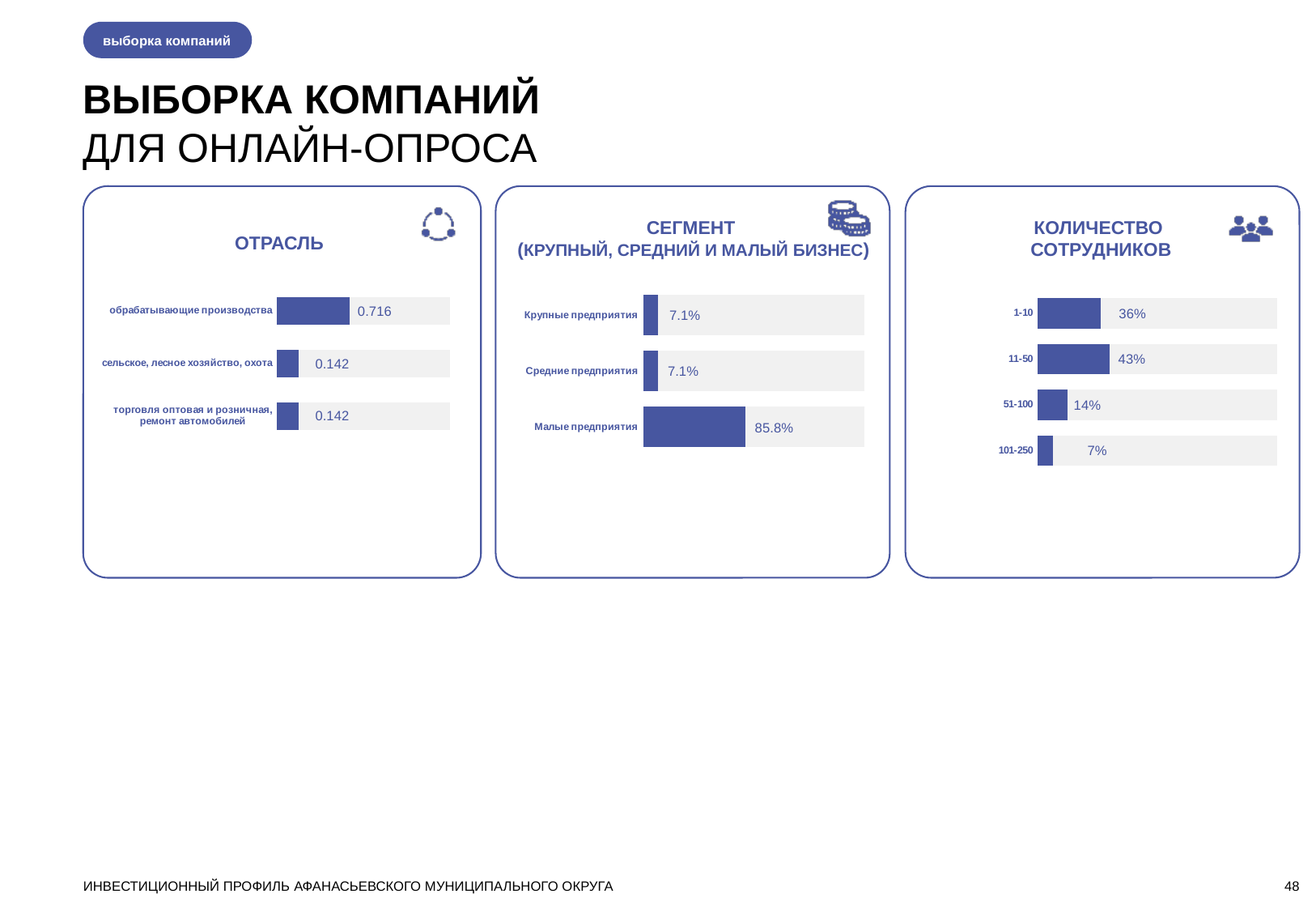
In the КОЛИЧЕСТВО СОТРУДНИКОВ chart, which is larger, 1-10 or 51-100? 1-10 In the ОТРАСЛЬ chart, how many categories are shown? 3 In the КОЛИЧЕСТВО СОТРУДНИКОВ chart, what is the value for 11-50? 43% In the ОТРАСЛЬ chart, what is the difference between обрабатывающие производства and сельское, лесное хозяйство, охота? 0.574 In the СЕГМЕНТ chart, what is the difference between Малые предприятия and Средние предприятия? 78.7% In the КОЛИЧЕСТВО СОТРУДНИКОВ chart, which category has the lowest value? 101-250 In the СЕГМЕНТ chart, what is the value for Крупные предприятия? 7.1% In the СЕГМЕНТ chart, what is the value for Малые предприятия? 85.8% In the СЕГМЕНТ chart, which category has the highest value? Малые предприятия In the ОТРАСЛЬ chart, which category has the highest value? обрабатывающие производства What kind of chart is the КОЛИЧЕСТВО СОТРУДНИКОВ chart? bar chart In the ОТРАСЛЬ chart, what is the value for обрабатывающие производства? 0.716